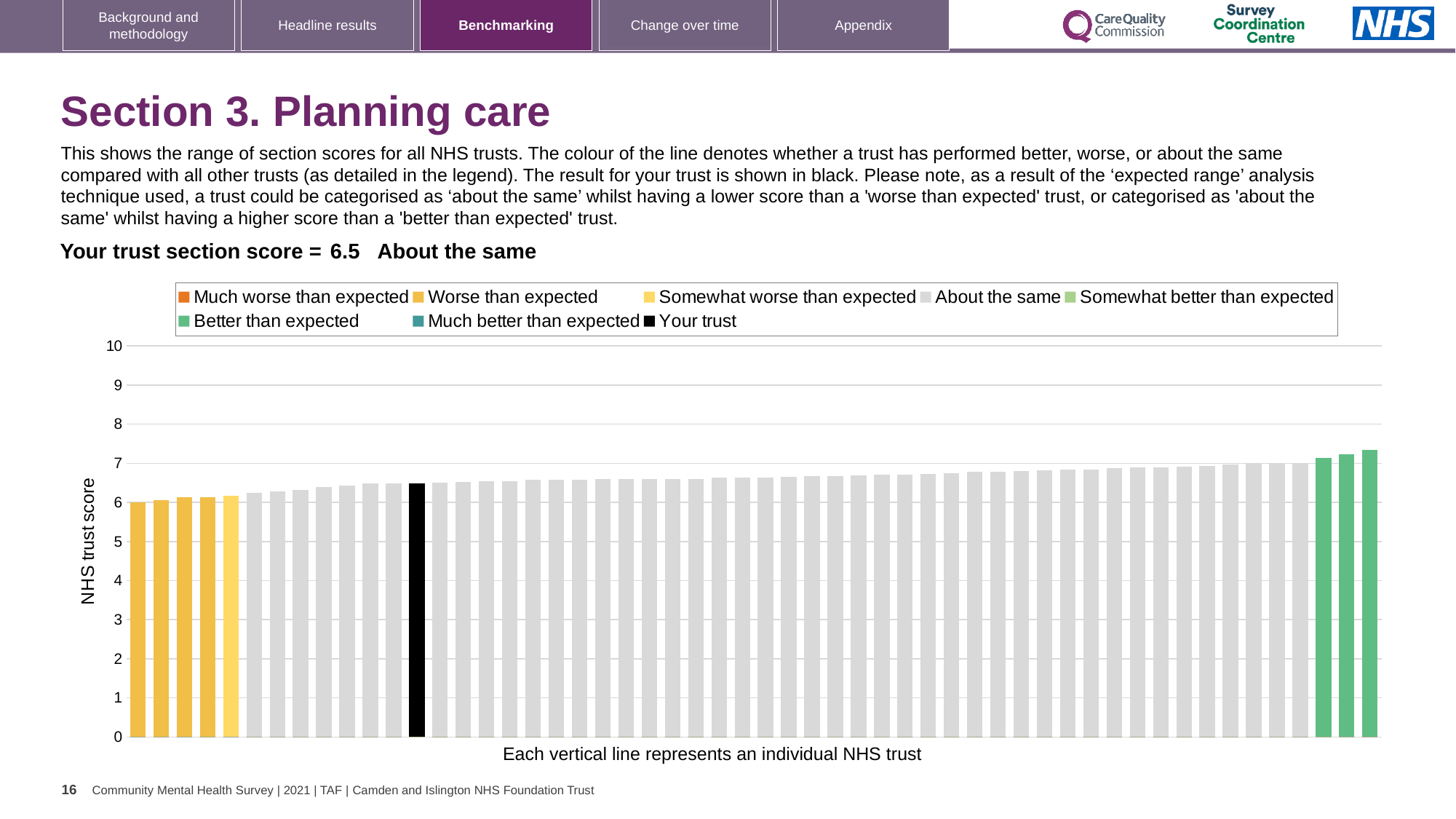
What is the section score for your trust shown on the slide? 6.5 How many entries does the chart legend list? 8 Is the value of the black 'Your trust' bar greater or less than 6? greater What colour is the bar representing your trust? Black How many bars are coloured green ('Better than expected')? 3 What is the label of the vertical axis? NHS trust score Which category does your trust fall into according to the slide? About the same Is the value of the shortest bar in the chart greater or less than 5? greater Do the bar values rise or fall from left to right along the x axis? rise Is the value of the black 'Your trust' bar greater or less than 7? less What kind of chart is shown on the slide? Bar chart